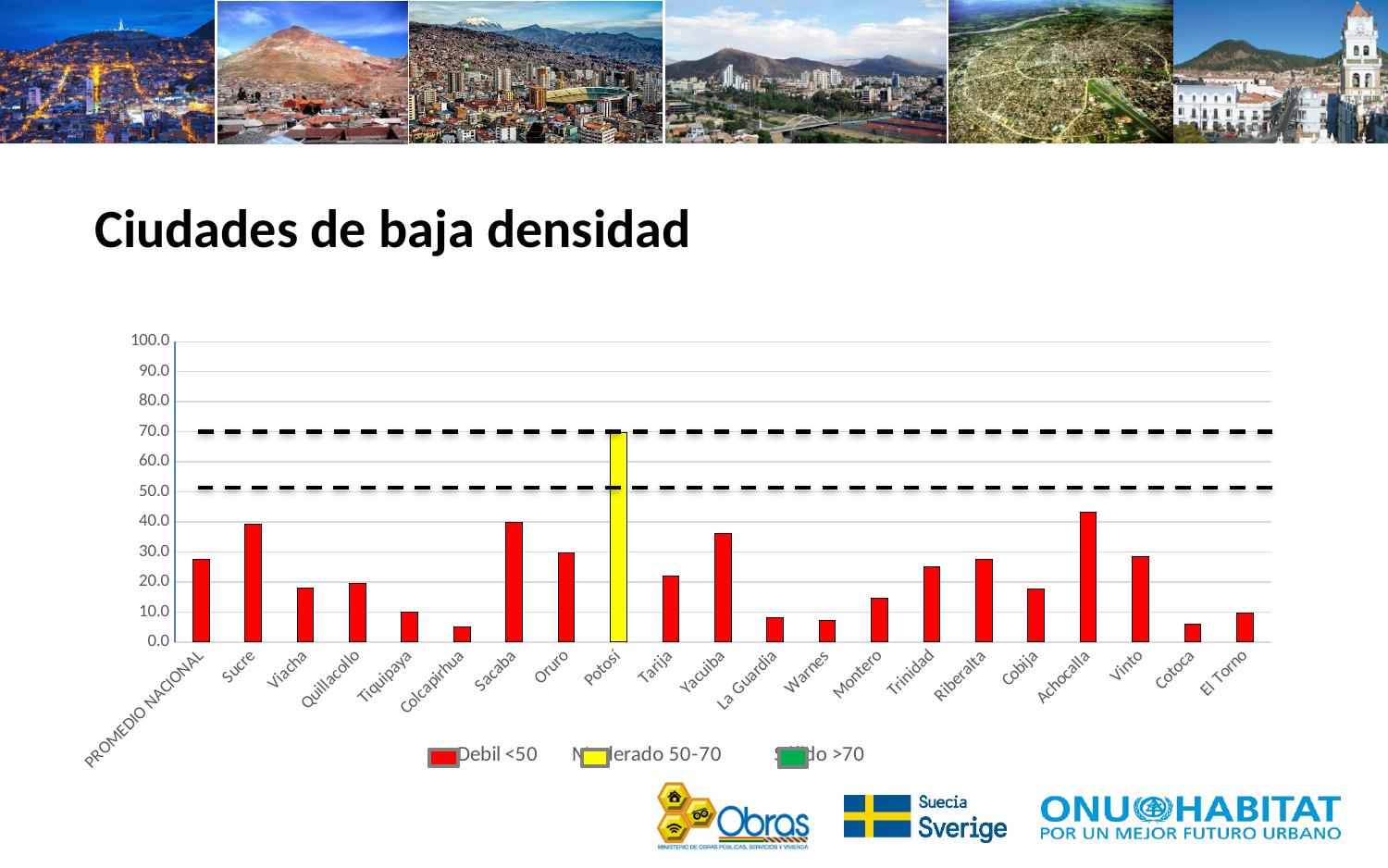
Is the value for Colcapirhua greater or less than 10? less Is the value for Warnes greater or less than 10? less Is the value for Sucre greater or less than 30? greater Which is larger, the value for Sucre or the value for Viacha? Sucre How many entries does the chart legend list? 3 How many categories are plotted along the x axis of the chart? 21 Which is larger, the value for Achocalla or the value for Montero? Achocalla What kind of chart is shown on the slide? bar chart What colour is the bar for Potosí? yellow Which category has the highest bar in the chart? Potosí